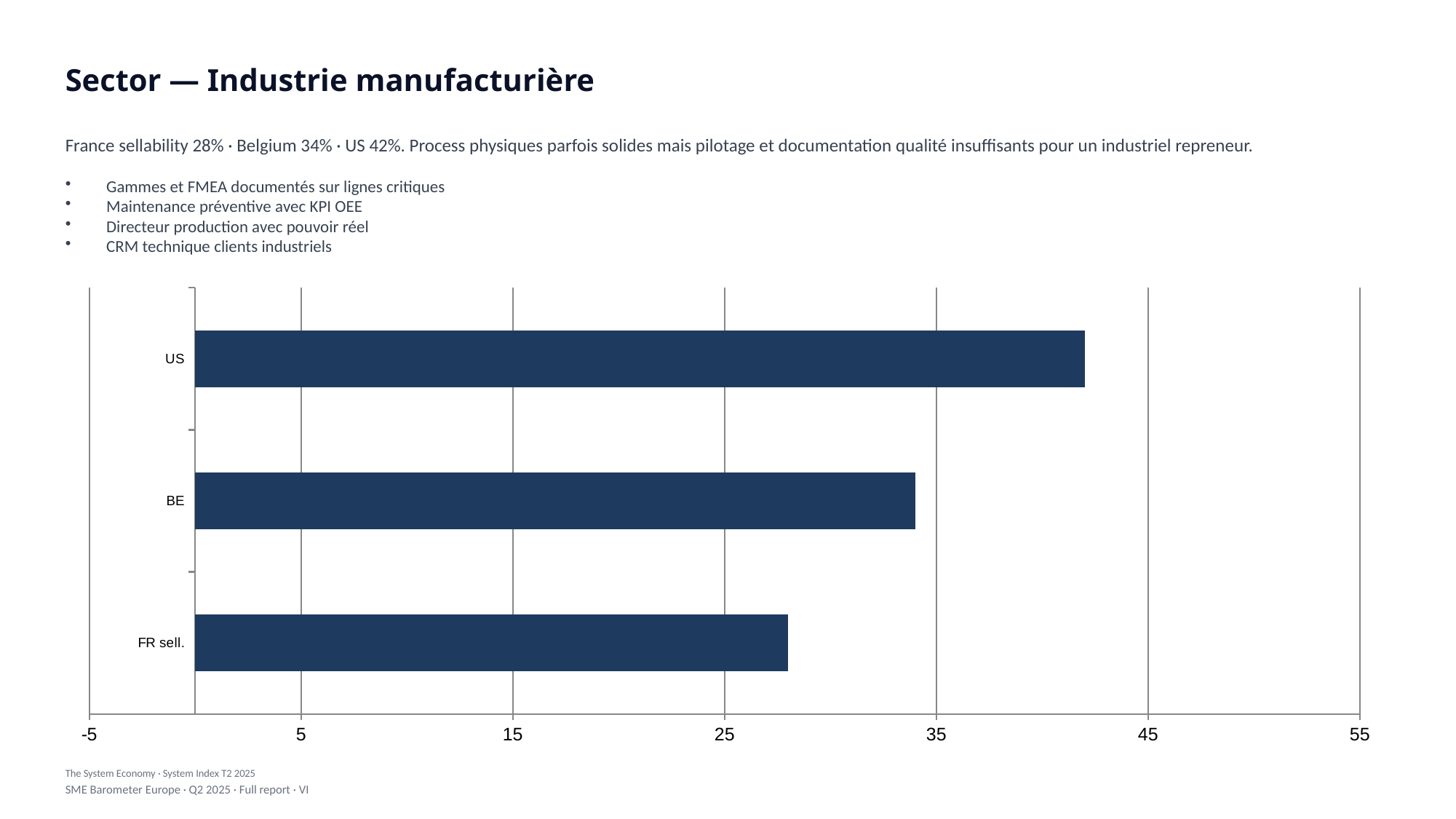
Which category has the highest value in the chart? US What kind of chart is shown on the slide? bar chart Is the value for US greater or less than 35? greater Is the value for BE greater or less than 25? greater Which category has the lowest value in the chart? FR sell. What is the title of the slide containing the chart? Sector — Industrie manufacturière Is the value for US greater or less than 45? less Which is larger, the value for BE or the value for FR sell.? BE Which is larger, the value for US or the value for BE? US How many categories are plotted in the chart? 3